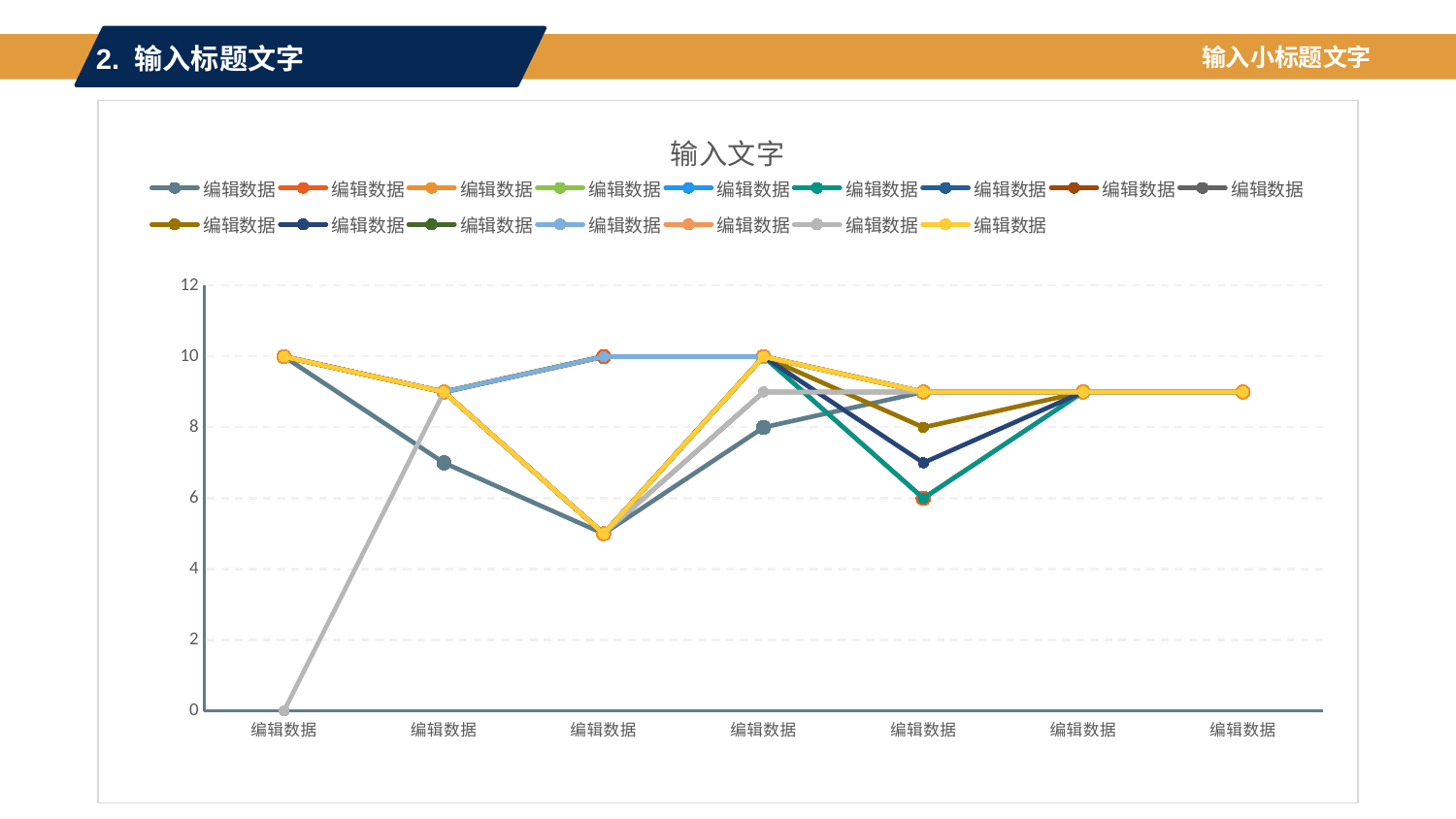
What is the highest tick value shown on the chart's y axis? 12 Is the value of the grey series at the first category greater or less than 2? less Does the grey series rise or fall from the first category to the second category? rise What is the highest value plotted anywhere on the chart? 10 What value does the grey series have at the first x-axis category? 0 How many categories are shown along the x axis of the chart? 7 What is the lowest value plotted anywhere on the chart? 0 What is the title of the chart? 输入文字 How many series does the chart legend list? 16 What kind of chart is shown on the slide? line chart